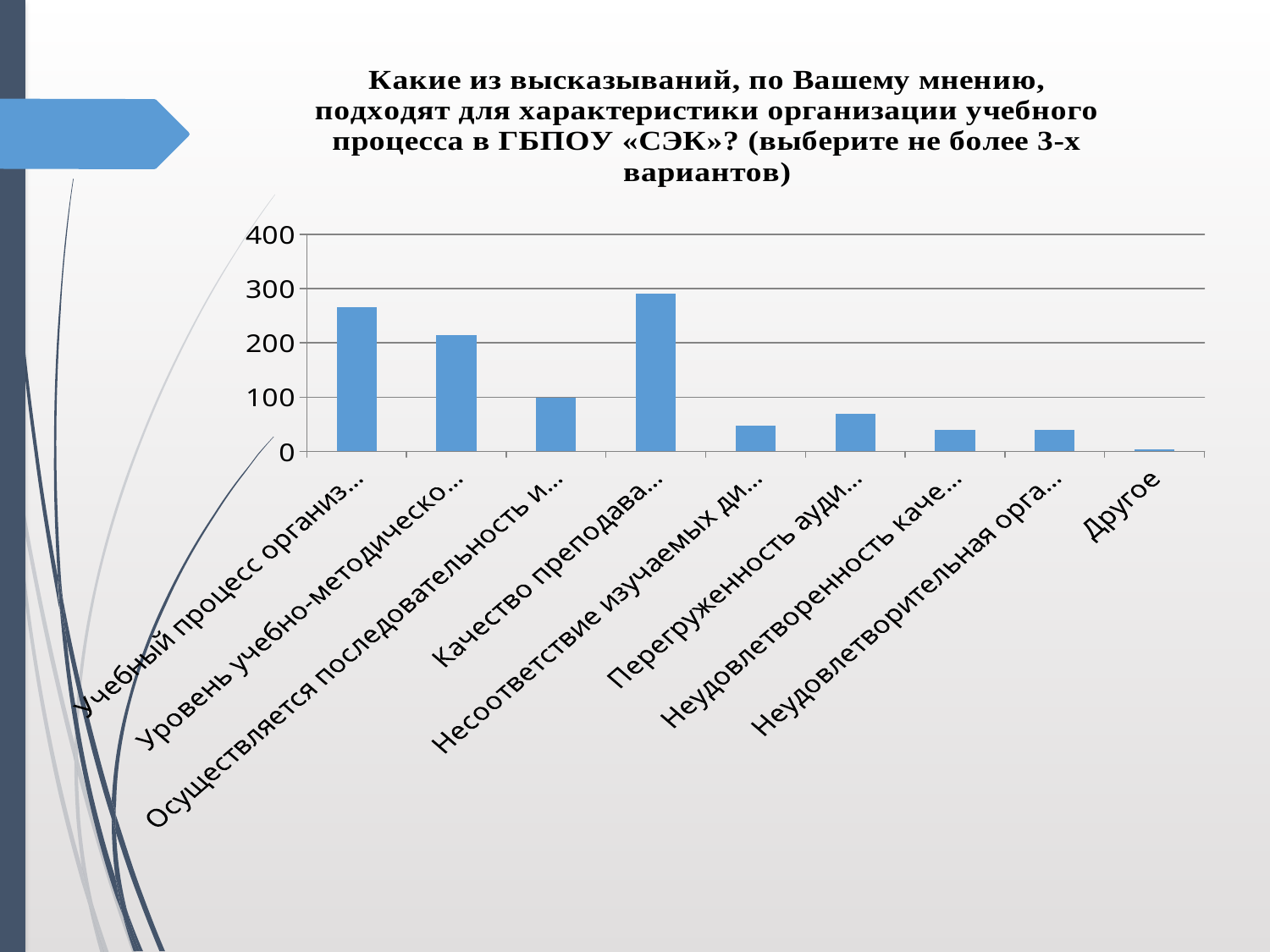
Is the value for "Перегруженность ауди..." greater or less than 100? less Which category has the lowest bar in the chart? Другое How many categories are plotted on the x axis of the chart? 9 Which category has the highest bar in the chart? Качество преподава... What is the highest value shown on the vertical axis of the chart? 400 Is the value for "Качество преподава..." greater or less than 300? less What kind of chart is shown on the slide? bar chart Is the value for "Уровень учебно-методическо..." greater or less than 200? greater Which is larger: the value for "Перегруженность ауди..." or the value for "Несоответствие изучаемых ди..."? Перегруженность ауди... Which is larger: the value for "Учебный процесс организ..." or the value for "Уровень учебно-методическо..."? Учебный процесс организ...